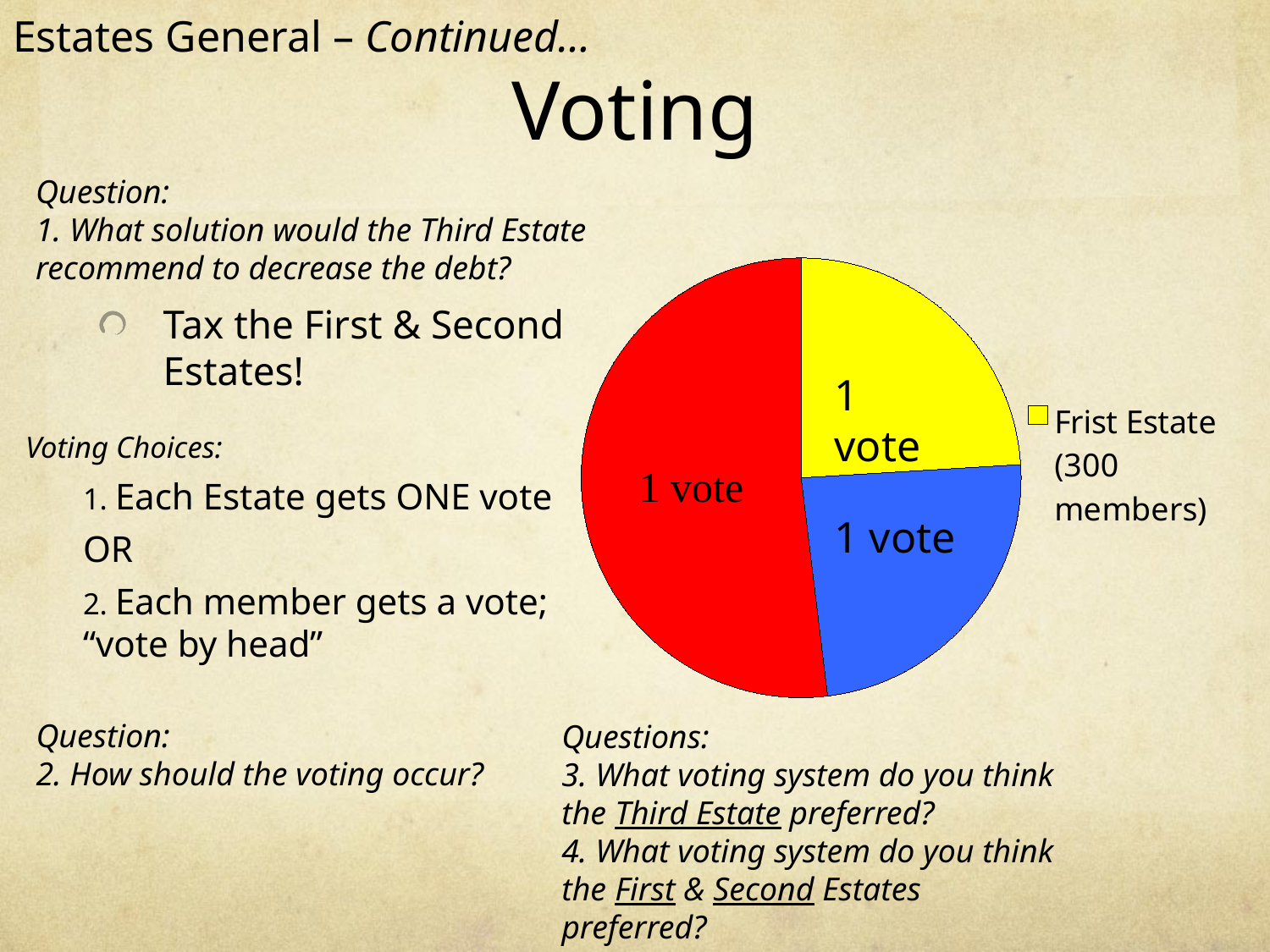
How many entries does the pie chart's legend list? 1 What kind of chart is shown on the slide? pie chart According to the legend, how many members does the Frist Estate have? 300 What text label is printed on the yellow slice of the pie chart? 1 vote Which is larger in the pie chart, the red slice or the yellow slice? the red slice How many slices does the pie chart have? 3 What legend entry is shown for the yellow slice of the pie chart? Frist Estate (300 members) What text label is printed on the red slice of the pie chart? 1 vote Which colour slice is the largest in the pie chart? red What text label is printed on the blue slice of the pie chart? 1 vote Which is larger in the pie chart, the red slice or the blue slice? the red slice